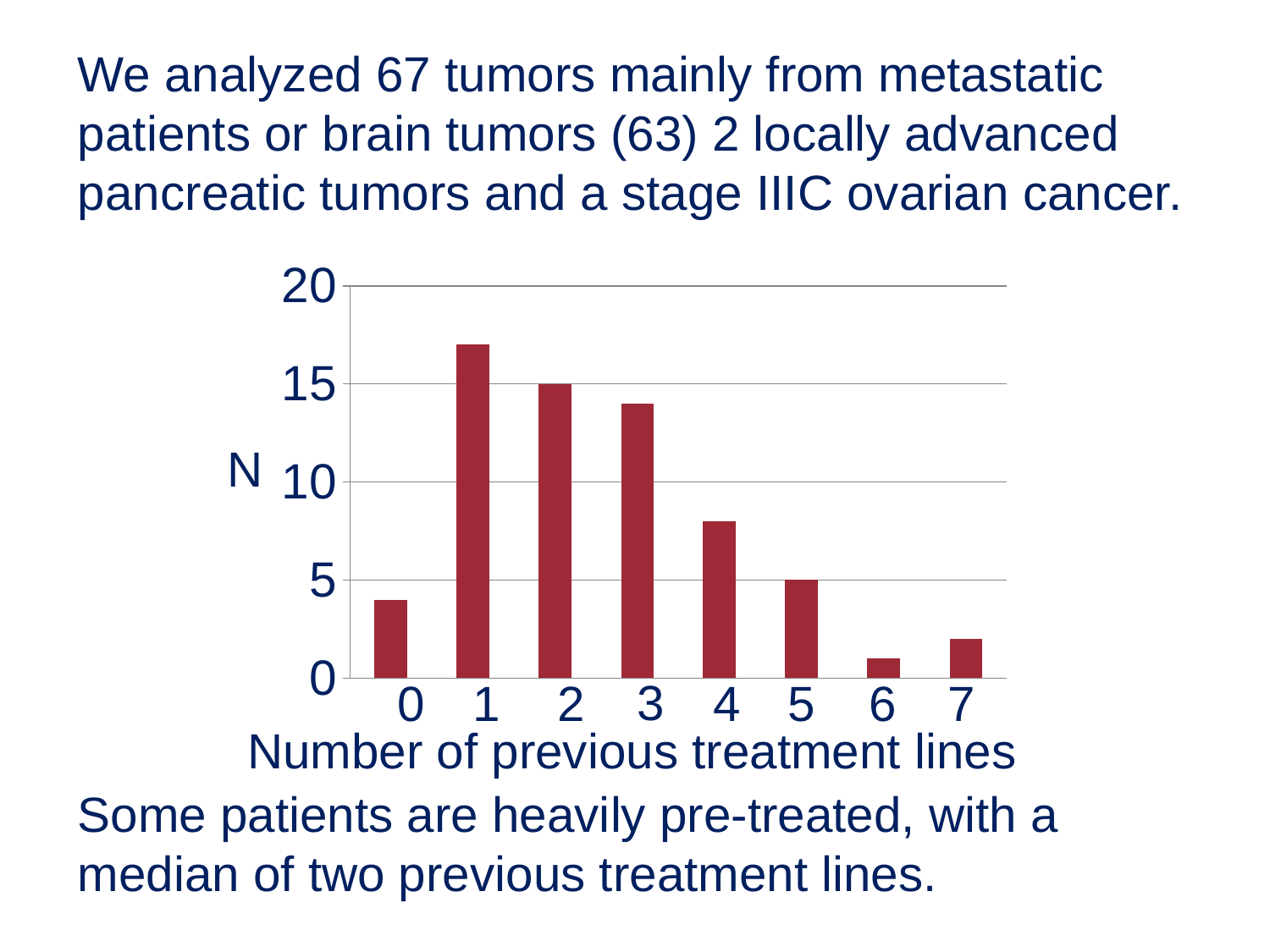
What is the value of N for 2 previous treatment lines? 15 What is the value of N for 5 previous treatment lines? 5 From 1 to 7 previous treatment lines, do the bar values generally rise or fall? fall Is the value for 1 previous treatment line greater or less than 15? greater What kind of chart is shown on the slide? bar chart What is the title of the x axis of the chart? Number of previous treatment lines Which has a larger value: 3 previous treatment lines or 4 previous treatment lines? 3 Which number of previous treatment lines has the lowest bar? 6 Is the value for 4 previous treatment lines greater or less than 10? less How many categories are shown on the x axis of the chart? 8 Is the value for 0 previous treatment lines greater or less than 5? less Which number of previous treatment lines has the highest bar? 1